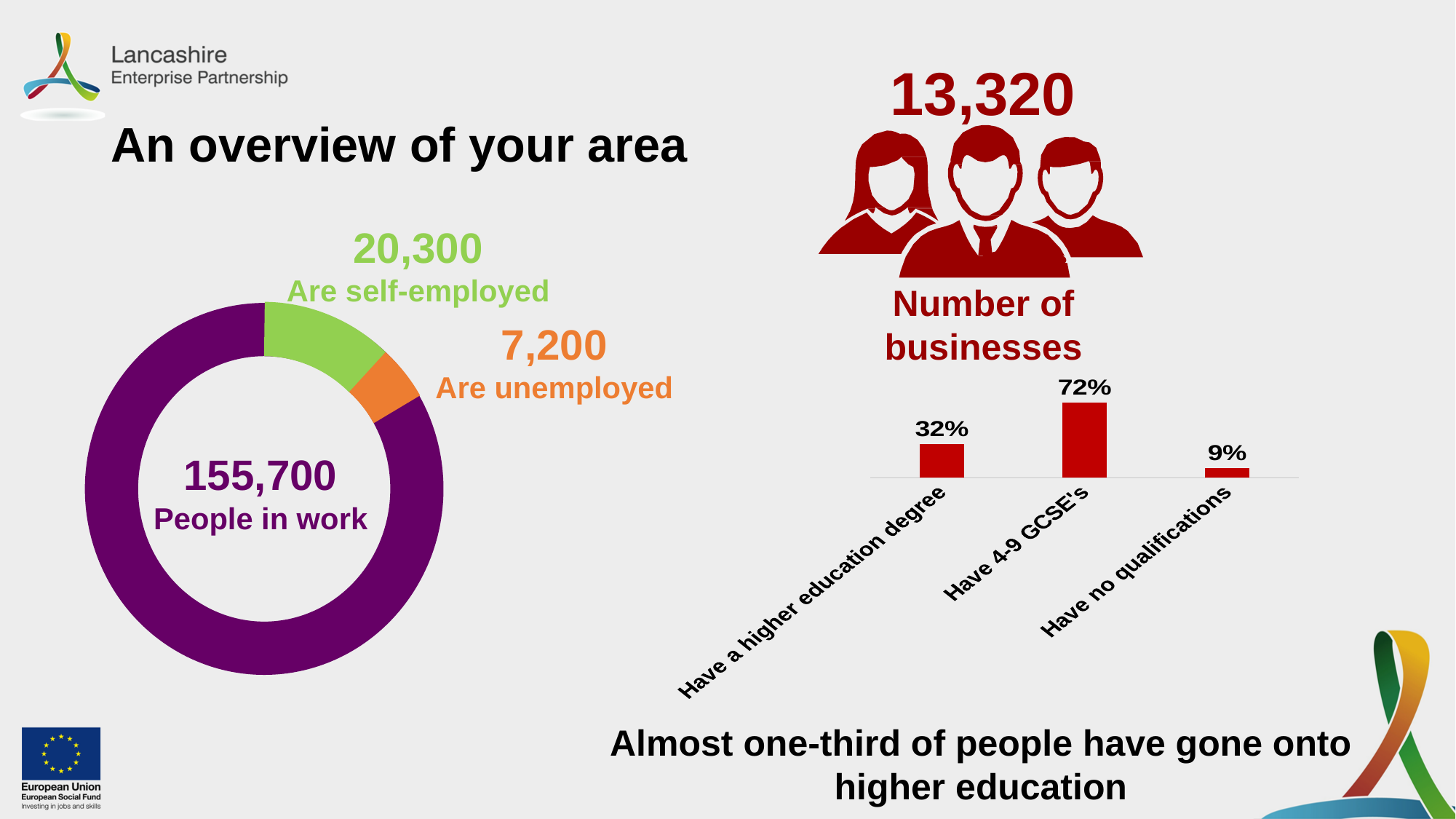
In the donut chart on the left, how many people are self-employed? 20,300 What kind of chart is shown on the right of the slide? Bar chart In the bar chart on the right, which category has the highest value? Have 4-9 GCSE's In the donut chart on the left, how many people are unemployed? 7,200 How many categories are shown in the bar chart on the right? 3 In the bar chart on the right, what is the difference between the percentage with 4-9 GCSE's and the percentage with a higher education degree? 40 percentage points In the bar chart on the right, what percentage of people have 4-9 GCSE's? 72% In the bar chart on the right, what percentage of people have a higher education degree? 32% In the bar chart on the right, which is larger: the value for 'Have a higher education degree' or 'Have no qualifications'? Have a higher education degree In the bar chart on the right, which category has the lowest value? Have no qualifications In the bar chart on the right, what percentage of people have no qualifications? 9% In the donut chart on the left, what is the difference between the number of self-employed people and the number of unemployed people? 13,100